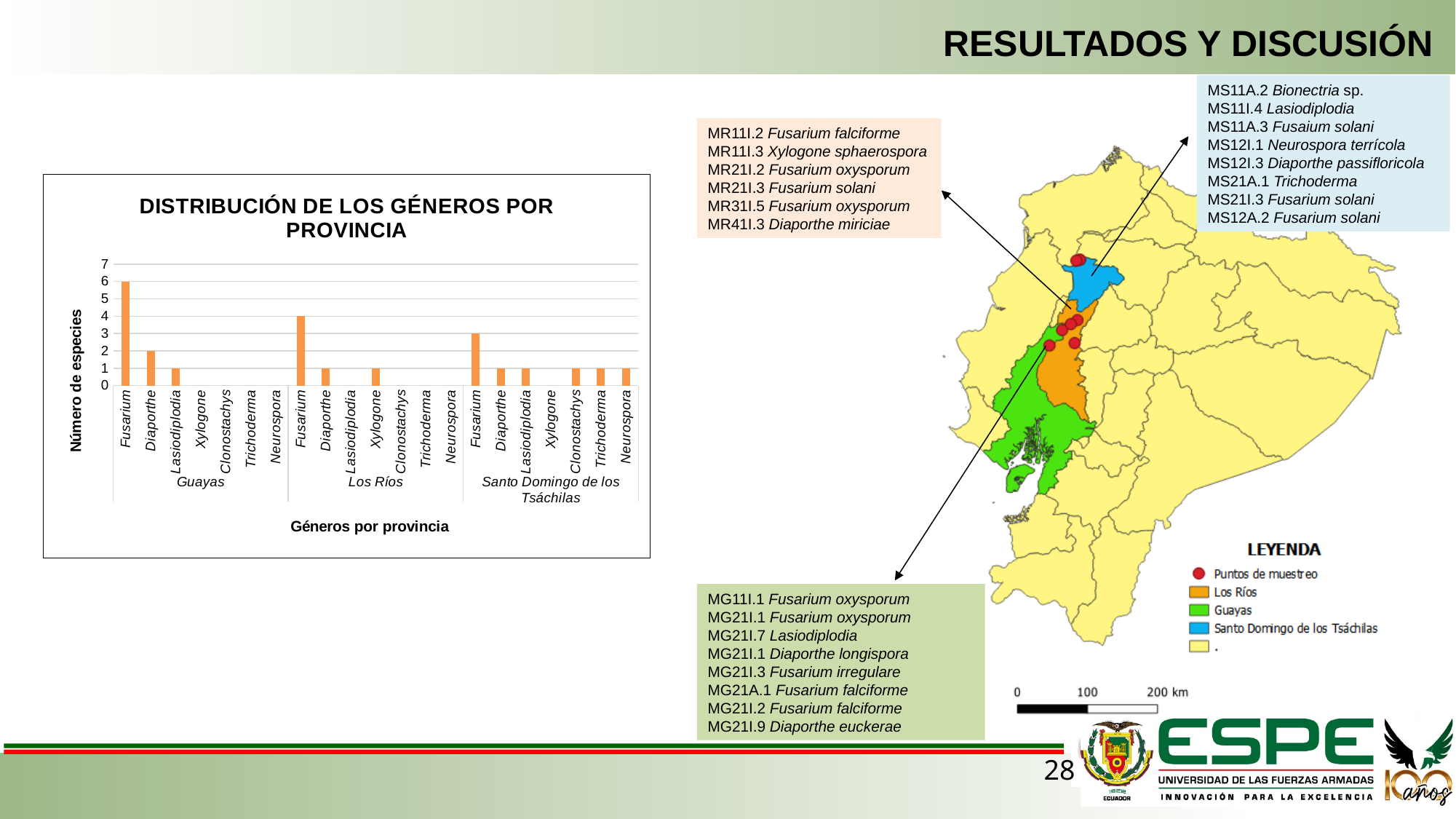
Which is larger: the number of Fusarium species in Los Ríos or in Santo Domingo de los Tsáchilas? Los Ríos How many species does the chart show for Fusarium in Los Ríos? 4 How many species does the chart show for Diaporthe in Guayas? 2 Is the value for Fusarium in Guayas greater or less than 5? greater What kind of chart is shown on the slide? Bar chart How many species does the chart show for Fusarium in Guayas? 6 How many provinces are shown along the x axis of the chart? 3 What is the difference between the number of Fusarium species in Guayas and in Los Ríos? 2 How many species does the chart show for Fusarium in Santo Domingo de los Tsáchilas? 3 What is the label of the vertical axis of the chart? Número de especies What is the title of the chart? DISTRIBUCIÓN DE LOS GÉNEROS POR PROVINCIA Which genus has the highest bar in the chart overall? Fusarium (Guayas)